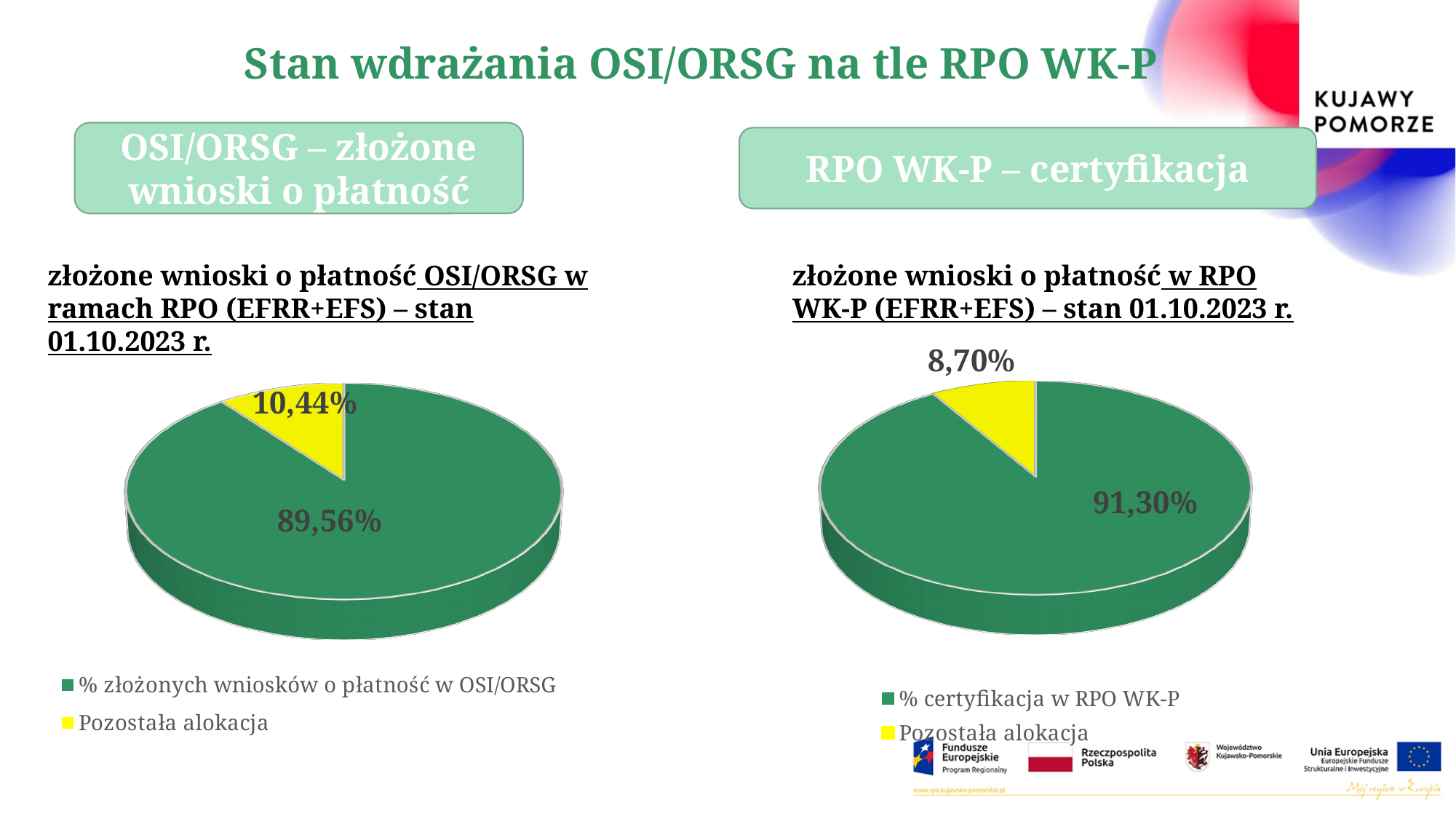
What is the difference between the 'Pozostała alokacja' share in the left pie chart and in the right pie chart? 1,74 percentage points How many entries does the legend of the left pie chart list? 2 In the left pie chart, which slice is the largest? % złożonych wniosków o płatność w OSI/ORSG In the left pie chart, what share is shown for 'Pozostała alokacja'? 10,44% How many slices does the right pie chart have? 2 Which is larger: 'Pozostała alokacja' in the left pie chart or 'Pozostała alokacja' in the right pie chart? left pie chart (10,44%) In the right pie chart, what share is shown for 'Pozostała alokacja'? 8,70% In the right pie chart, which slice is the smallest? Pozostała alokacja In the right pie chart, what share is shown for '% certyfikacja w RPO WK-P'? 91,30% What kind of chart is the left chart on the slide? pie chart What colour is the 'Pozostała alokacja' slice in both pie charts? yellow In the left pie chart, what share is shown for '% złożonych wniosków o płatność w OSI/ORSG'? 89,56%